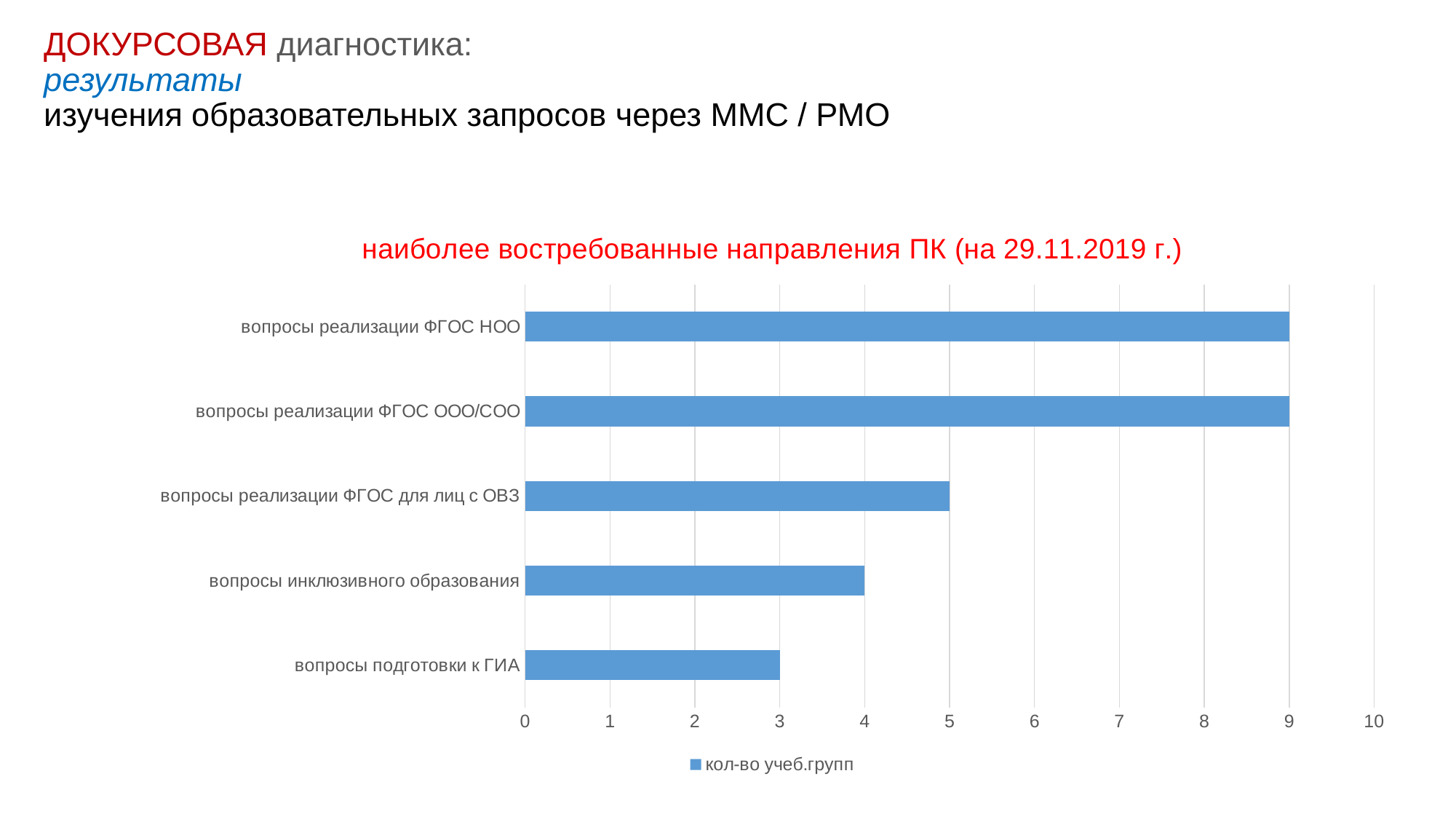
Which category has the lowest value? вопросы подготовки к ГИА How many series does the legend list? 1 What kind of chart is shown on the slide? bar chart Is the value for "вопросы реализации ФГОС НОО" greater or less than 8? greater What is the value for "вопросы реализации ФГОС НОО"? 9 What is the title of the chart? наиболее востребованные направления ПК (на 29.11.2019 г.) What is the value for "вопросы реализации ФГОС для лиц с ОВЗ"? 5 What is the value for "вопросы инклюзивного образования"? 4 Which is larger: the value for "вопросы реализации ФГОС для лиц с ОВЗ" or for "вопросы инклюзивного образования"? вопросы реализации ФГОС для лиц с ОВЗ What is the value for "вопросы подготовки к ГИА"? 3 What is the difference between the values for "вопросы реализации ФГОС ООО/СОО" and "вопросы подготовки к ГИА"? 6 How many categories are shown in the chart? 5